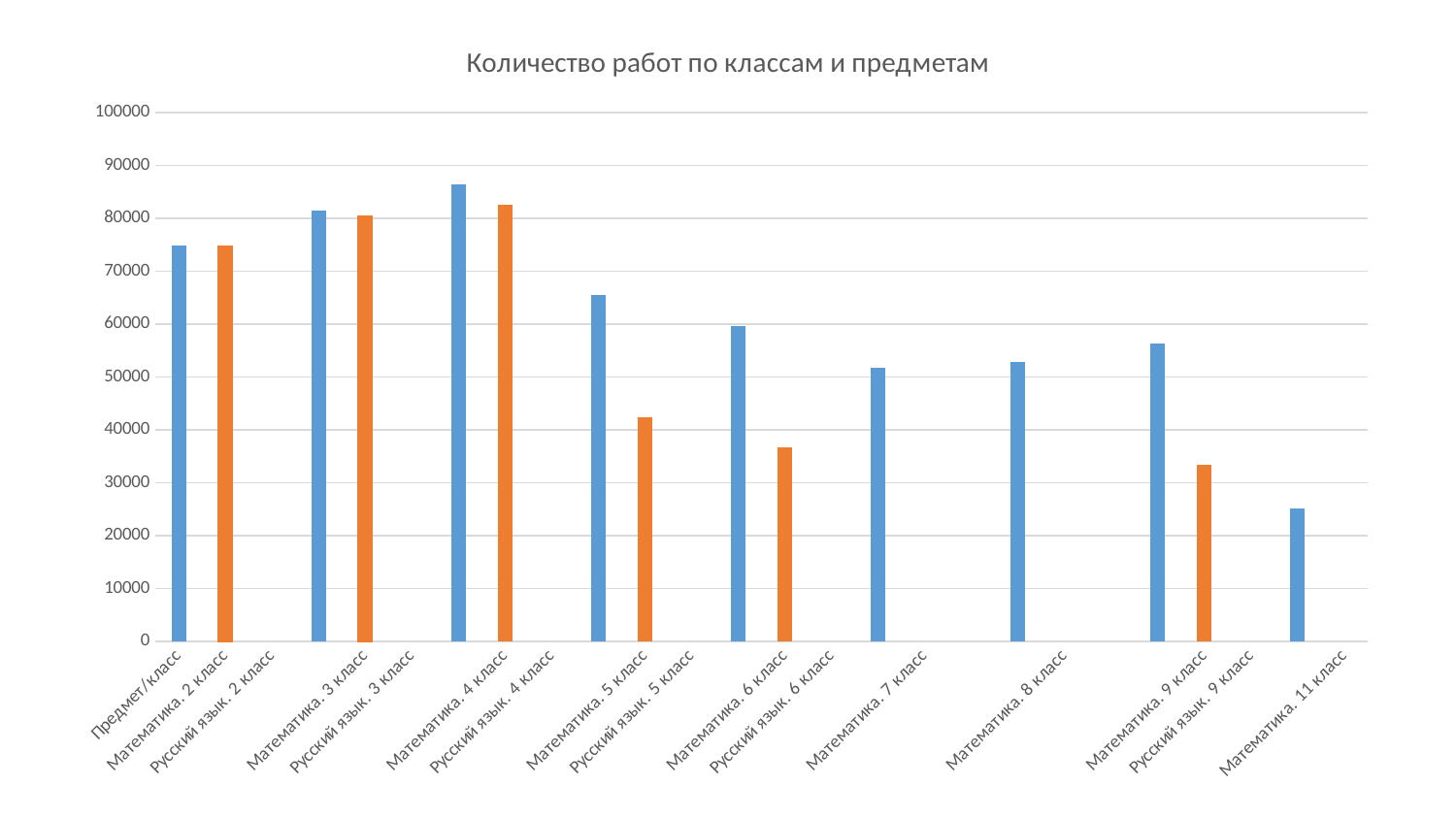
Which has the larger value, Математика. 6 класс or Русский язык. 6 класс? Математика. 6 класс What is the highest value shown on the vertical axis? 100000 Is the value for Русский язык. 9 класс greater or less than 30000? greater Which category has the shortest bar? Математика. 11 класс What is the title of the chart? Количество работ по классам и предметам Is the value for Математика. 7 класс greater or less than 60000? less Which category has the tallest bar? Математика. 4 класс Is the value for Русский язык. 6 класс greater or less than 40000? less Which has the larger value, Математика. 5 класс or Русский язык. 5 класс? Математика. 5 класс What type of chart is shown on the slide? bar chart